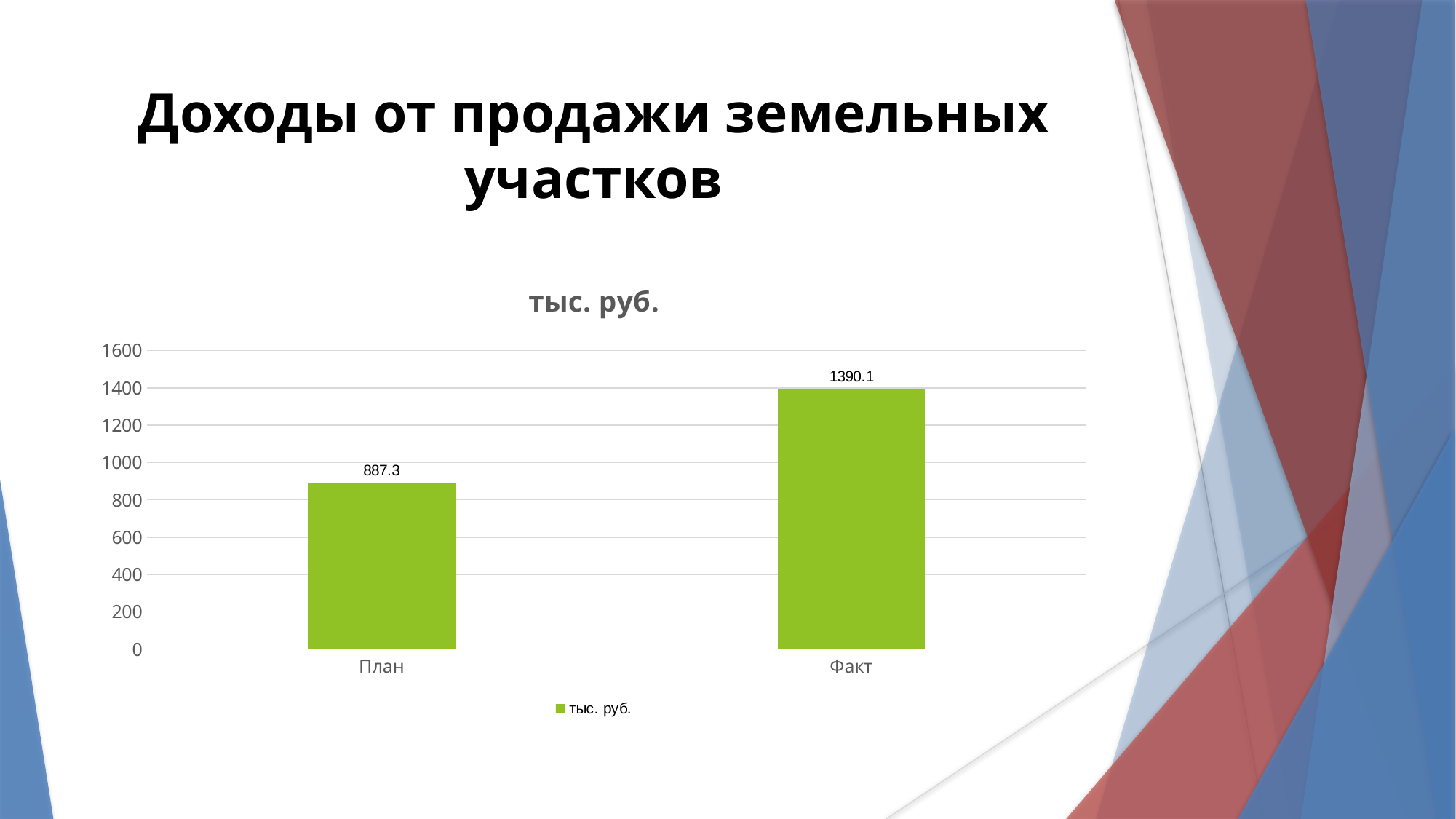
Is the value for План greater or less than 1000? less Which category has the highest value? Факт Is the value for Факт greater or less than 1200? greater How many categories are shown on the x axis? 2 What is the value for Факт? 1390.1 Which is larger, the value for План or the value for Факт? Факт What is the title of the chart? тыс. руб. Which category has the lowest value? План What is the value for План? 887.3 What kind of chart is shown on the slide? bar chart How many series does the legend list? 1 What is the difference between the values for Факт and План? 502.8